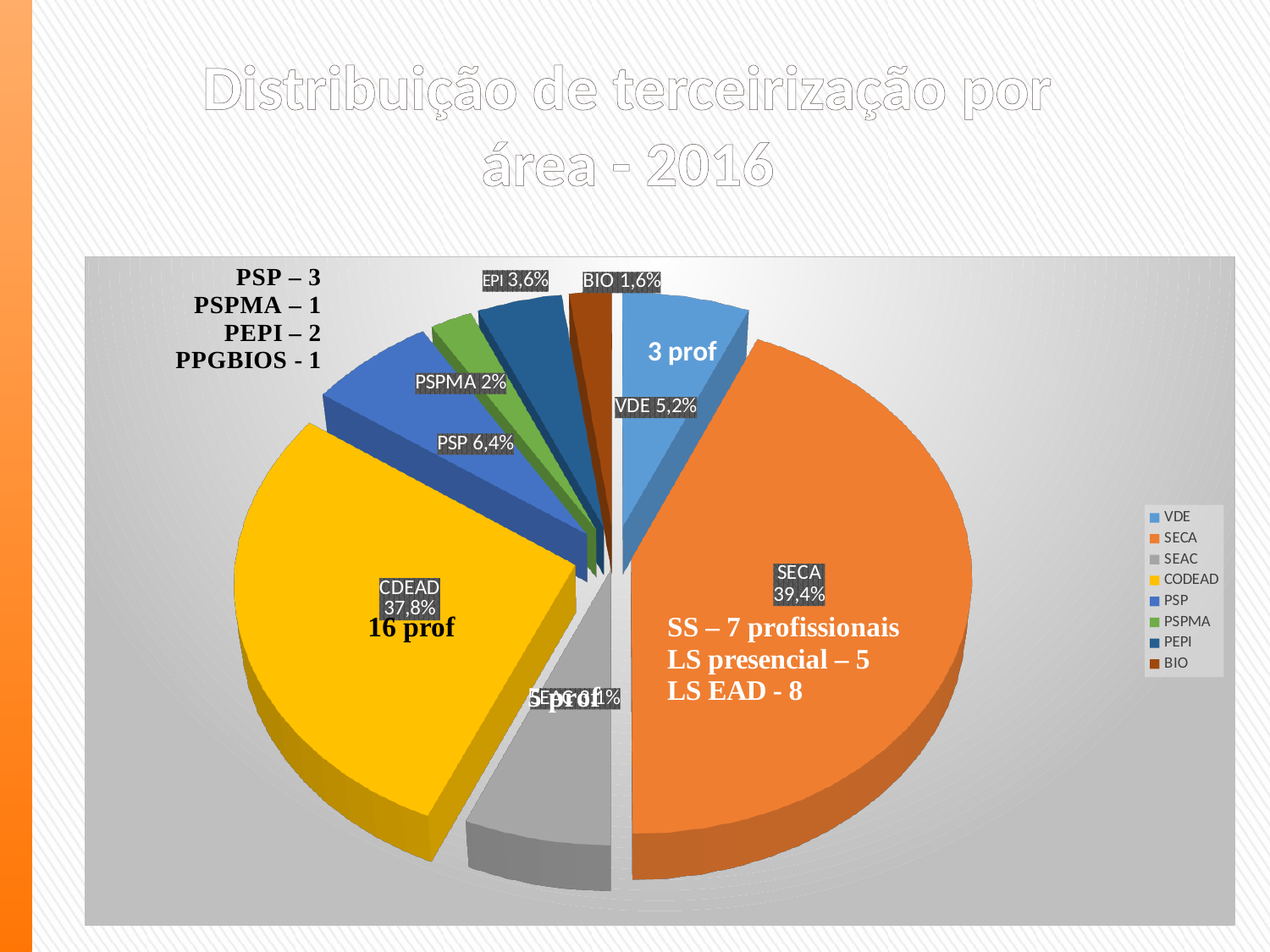
Which slice is larger, PSP or VDE? PSP What percentage share does the PSPMA slice have? 2% What percentage share does the VDE slice have? 5,2% What percentage share does the PSP slice have? 6,4% What kind of chart is shown on the slide? pie chart By how many percentage points does the SECA share exceed the CODEAD share? 1,6% What percentage share does the SECA slice have? 39,4% Which area has the largest share of the pie? SECA What percentage share does the CODEAD slice have? 37,8% How many entries does the legend list? 8 Which area has the smallest share of the pie? BIO What percentage share does the BIO slice have? 1,6%